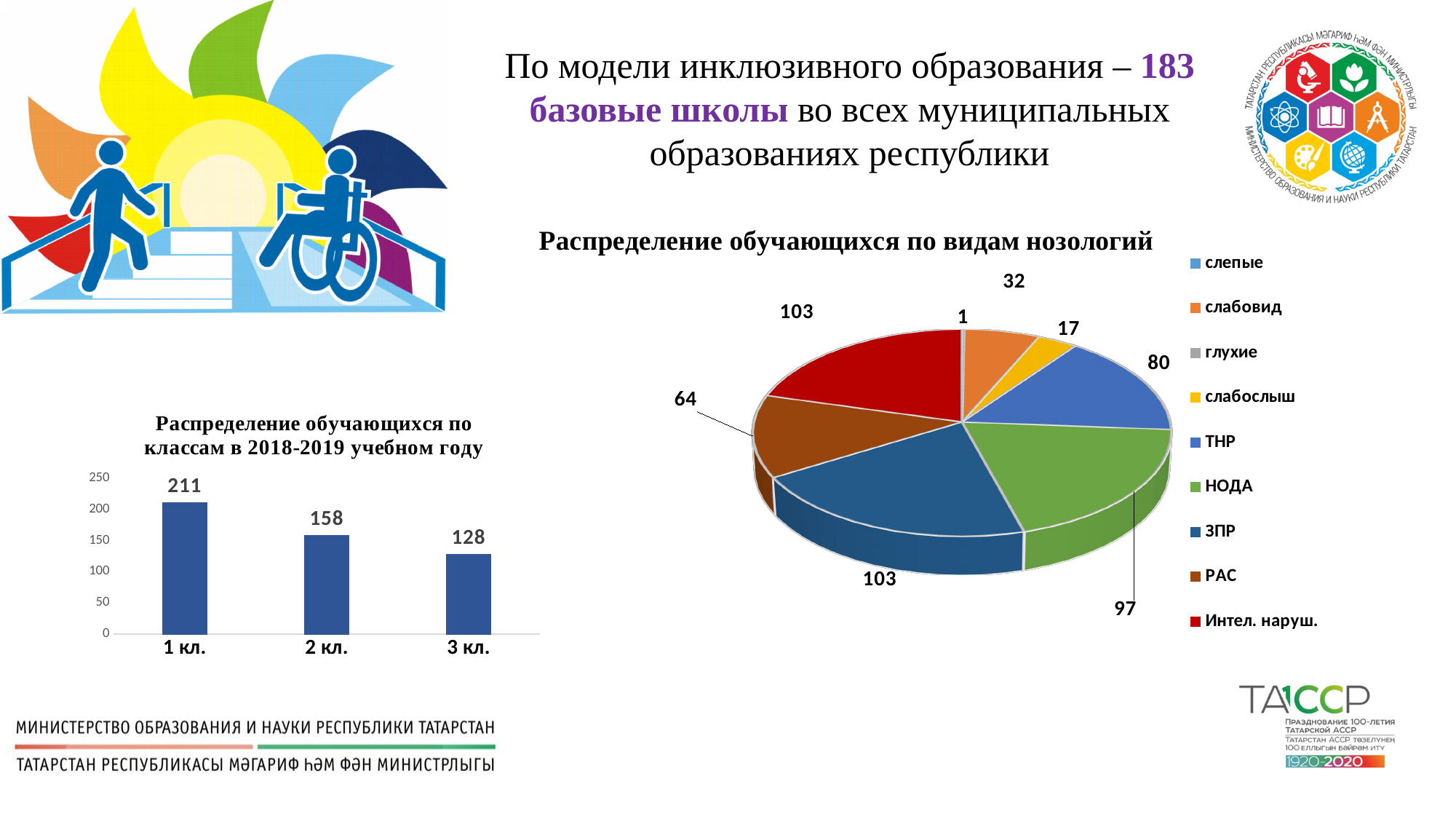
In the bar chart 'Распределение обучающихся по классам в 2018-2019 учебном году', what is the value for 1 кл.? 211 How many categories are shown in the bar chart 'Распределение обучающихся по классам в 2018-2019 учебном году'? 3 How many entries does the legend of the pie chart 'Распределение обучающихся по видам нозологий' list? 9 In the pie chart 'Распределение обучающихся по видам нозологий', what is the value for ТНР? 80 In the bar chart 'Распределение обучающихся по классам в 2018-2019 учебном году', which class has the highest value? 1 кл. In the bar chart 'Распределение обучающихся по классам в 2018-2019 учебном году', what is the difference between the values for 1 кл. and 2 кл.? 53 In the pie chart 'Распределение обучающихся по видам нозологий', what is the value for НОДА? 97 In the bar chart 'Распределение обучающихся по классам в 2018-2019 учебном году', which class has the lowest value? 3 кл. In the pie chart 'Распределение обучающихся по видам нозологий', which is larger, ЗПР or РАС? ЗПР What kind of chart is 'Распределение обучающихся по видам нозологий'? pie chart In the bar chart 'Распределение обучающихся по классам в 2018-2019 учебном году', do the values rise or fall from 1 кл. to 3 кл.? fall In the bar chart 'Распределение обучающихся по классам в 2018-2019 учебном году', what is the value for 3 кл.? 128